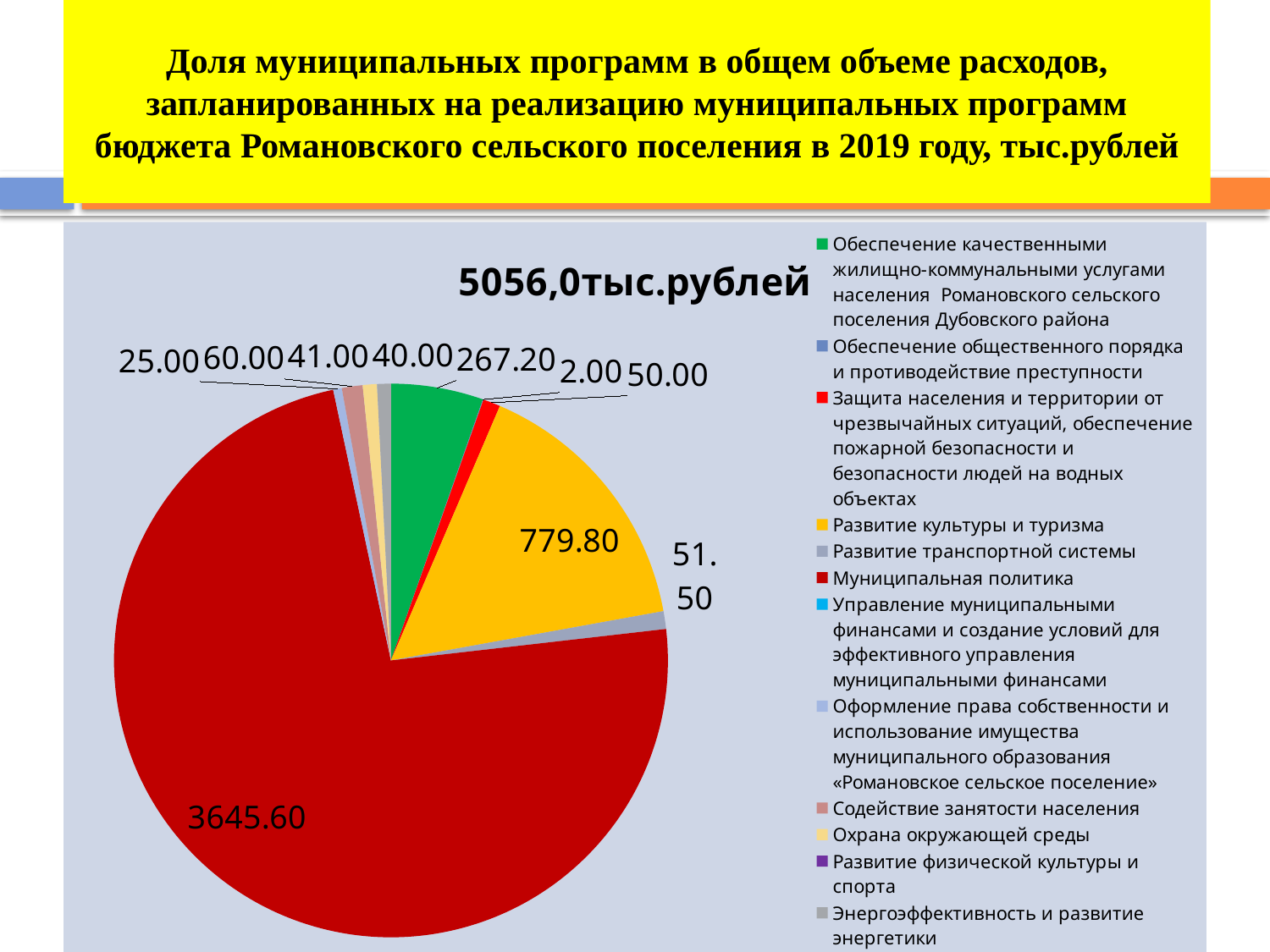
Which category has the largest slice in the pie chart? Муниципальная политика Which is larger, the value for Развитие культуры и туризма or the value for Обеспечение качественными жилищно-коммунальными услугами? Развитие культуры и туризма What is the value labeled on the largest slice of the pie chart? 3645.60 What kind of chart is shown on the slide? pie chart What is the value for Развитие культуры и туризма? 779.80 What is the value for Обеспечение качественными жилищно-коммунальными услугами населения Романовского сельского поселения Дубовского района? 267.20 What colour is the slice for Муниципальная политика? dark red What is the smallest value labeled on the pie chart? 2.00 What is the title shown above the pie chart? 5056,0тыс.рублей What is the difference between the value for Муниципальная политика and the value for Развитие культуры и туризма? 2865.80 What is the value for Развитие транспортной системы? 51.50 How many categories does the legend of the pie chart list? 12